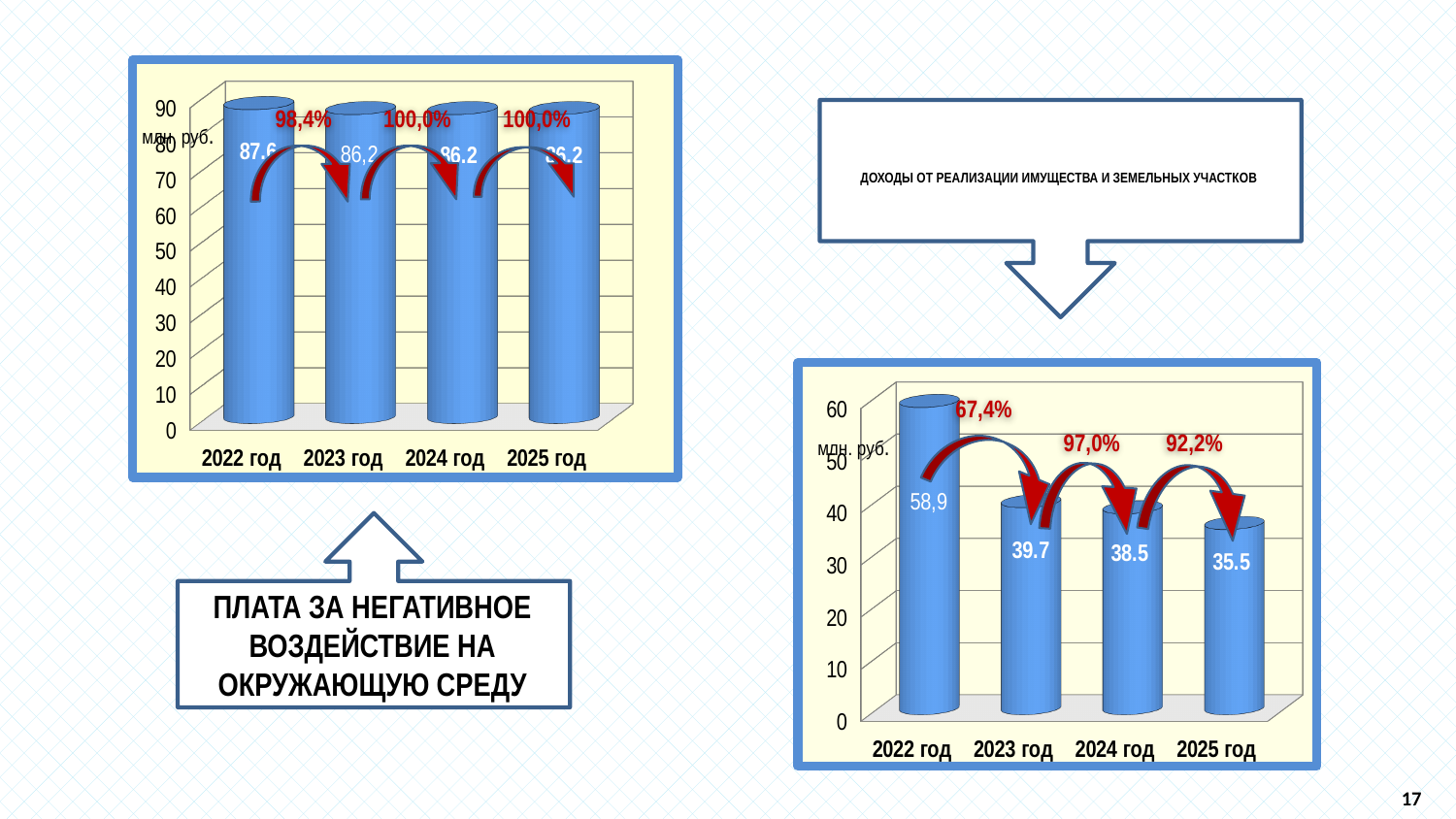
In the chart for 'Доходы от реализации имущества и земельных участков' (right), what is the value for 2022 год? 58,9 In the right chart ('Доходы от реализации имущества и земельных участков'), what is the difference between the values for 2022 год and 2025 год? 23,4 In the chart for 'Плата за негативное воздействие на окружающую среду' (left), what is the value for 2022 год? 87,6 In the right chart ('Доходы от реализации имущества и земельных участков'), do the values rise or fall from 2022 год to 2025 год? fall How many years (categories) are shown in the left chart ('Плата за негативное воздействие на окружающую среду')? 4 In the right chart ('Доходы от реализации имущества и земельных участков'), which year has the lowest value? 2025 год In the chart for 'Доходы от реализации имущества и земельных участков' (right), what is the value for 2025 год? 35.5 In the chart for 'Плата за негативное воздействие на окружающую среду' (left), what is the value for 2023 год? 86,2 In the right chart ('Доходы от реализации имущества и земельных участков'), which year has the highest value? 2022 год In the chart for 'Доходы от реализации имущества и земельных участков' (right), what is the value for 2024 год? 38.5 What type of chart is the right chart ('Доходы от реализации имущества и земельных участков')? bar chart In the left chart ('Плата за негативное воздействие на окружающую среду'), what is the difference between the values for 2022 год and 2023 год? 1,4